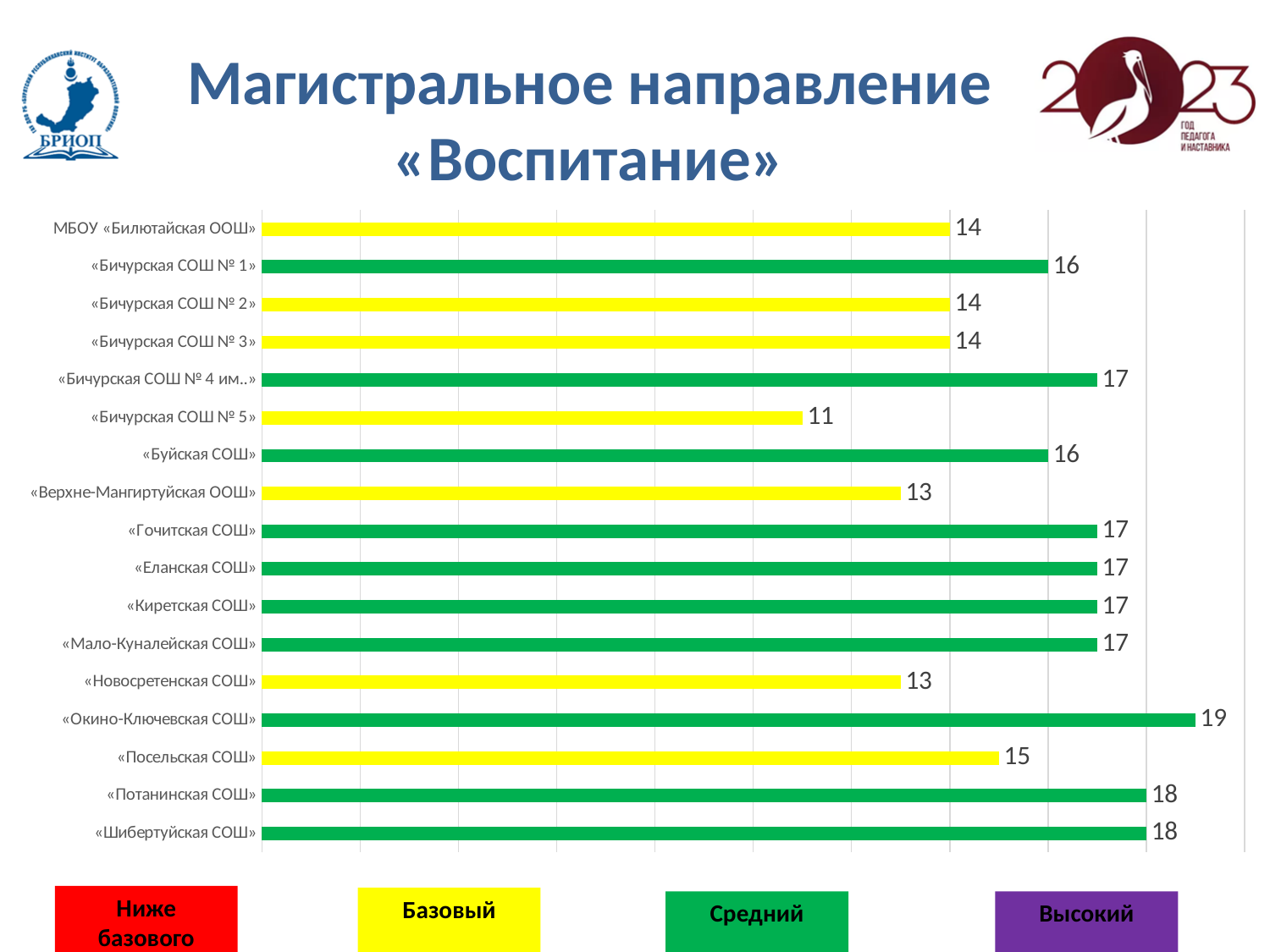
Which is larger, the value for «Бичурская СОШ № 1» or the value for «Бичурская СОШ № 2»? «Бичурская СОШ № 1» What is the value for «Окино-Ключевская СОШ»? 19 What is the difference between the values for «Потанинская СОШ» and «Посельская СОШ»? 3 How many schools are shown in the chart? 17 What kind of chart is shown on the slide? Bar chart What is the difference between the values for «Окино-Ключевская СОШ» and «Бичурская СОШ № 5»? 8 Which school has the lowest value? «Бичурская СОШ № 5» Which school has the highest value? «Окино-Ключевская СОШ» What is the value for «Посельская СОШ»? 15 What is the value for «Бичурская СОШ № 5»? 11 What is the value for «Верхне-Мангиртуйская ООШ»? 13 According to the legend at the bottom of the slide, which level does the yellow colour represent? Базовый